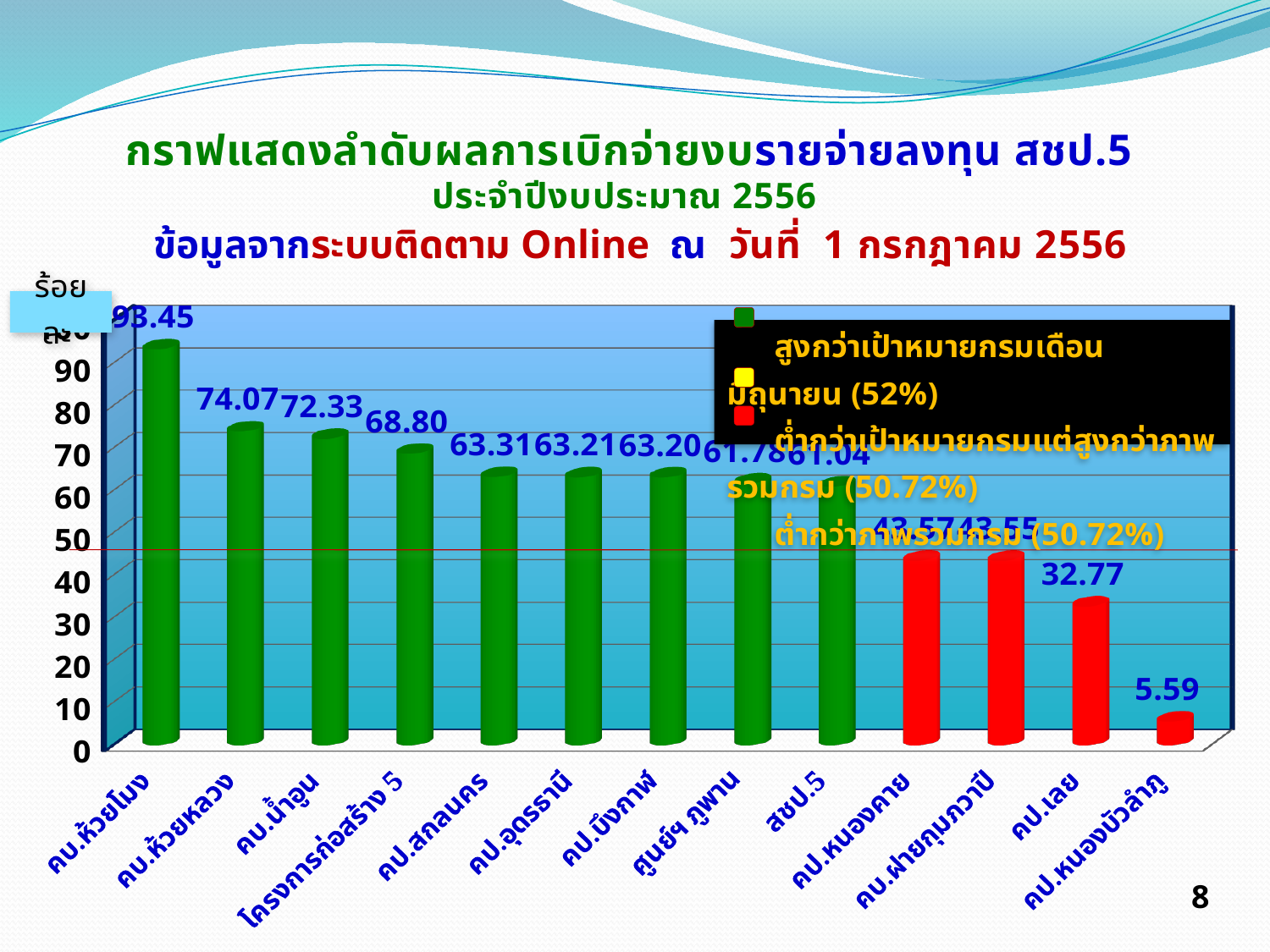
What is the value for คป.เลย? 32.77 What is the difference between the values for คบ.ห้วยโมง and คบ.ห้วยหลวง? 19.38 What is the value for คบ.ห้วยหลวง? 74.07 Do the values rise or fall from left to right along the x axis? fall What is the value for คบ.ห้วยโมง? 93.45 What is the value for คป.หนองบัวลำภู? 5.59 What kind of chart is shown on the slide? bar chart Which category has the lowest value? คป.หนองบัวลำภู How many categories are shown on the x axis? 13 Which has a larger value, คบ.น้ำอูน or โครงการก่อสร้าง 5? คบ.น้ำอูน Which category has the highest value? คบ.ห้วยโมง What is the difference between the values for คป.เลย and คป.หนองบัวลำภู? 27.18